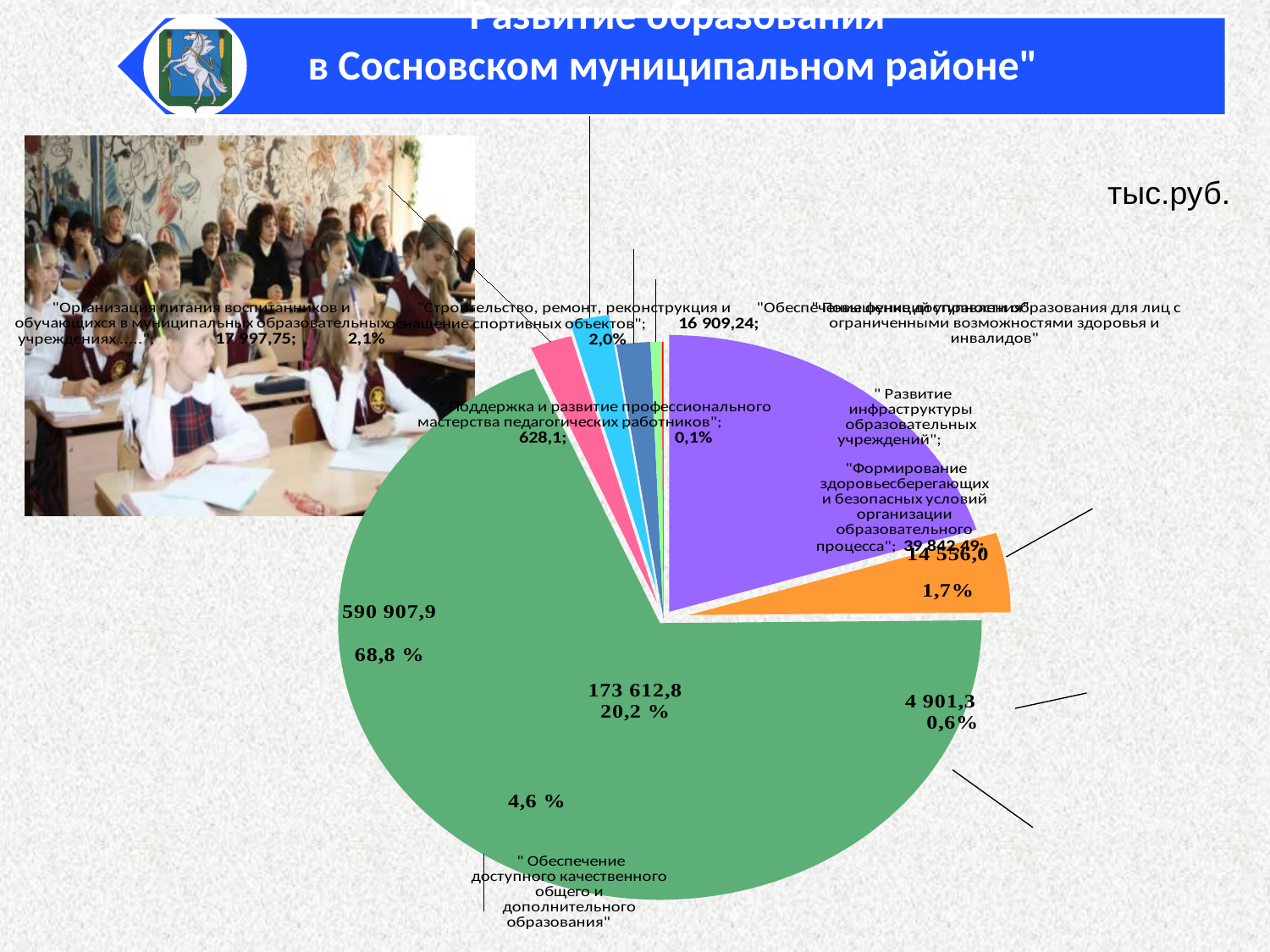
What share is labelled next to the value 4 901,3? 0,6% What share of the pie is labelled for "Строительство, ремонт, реконструкция и оснащение спортивных объектов"? 2,0% What value is shown for "Организация питания воспитанников и обучающихся в муниципальных образовательных учреждениях"? 17 997,75 What unit is stated for the values in the pie chart? тыс.руб. What value is paired with the 20,2 % share in the pie chart? 173 612,8 What is the difference between the value for "Организация питания воспитанников и обучающихся..." (17 997,75) and the value for "Строительство, ремонт, реконструкция и оснащение спортивных объектов" (16 909,24)? 1 088,51 Is the share of the largest slice greater or less than 50%? greater What kind of chart is shown on the slide? pie chart What share of the pie does the largest slice, "Обеспечение доступного качественного общего и дополнительного образования", represent? 68,8 % What value is shown for "Поддержка и развитие профессионального мастерства педагогических работников"? 628,1 What is the value of the largest slice of the pie chart? 590 907,9 Which is larger: the value for "Организация питания воспитанников и обучающихся..." or the value for "Строительство, ремонт, реконструкция и оснащение спортивных объектов"? Организация питания воспитанников и обучающихся...